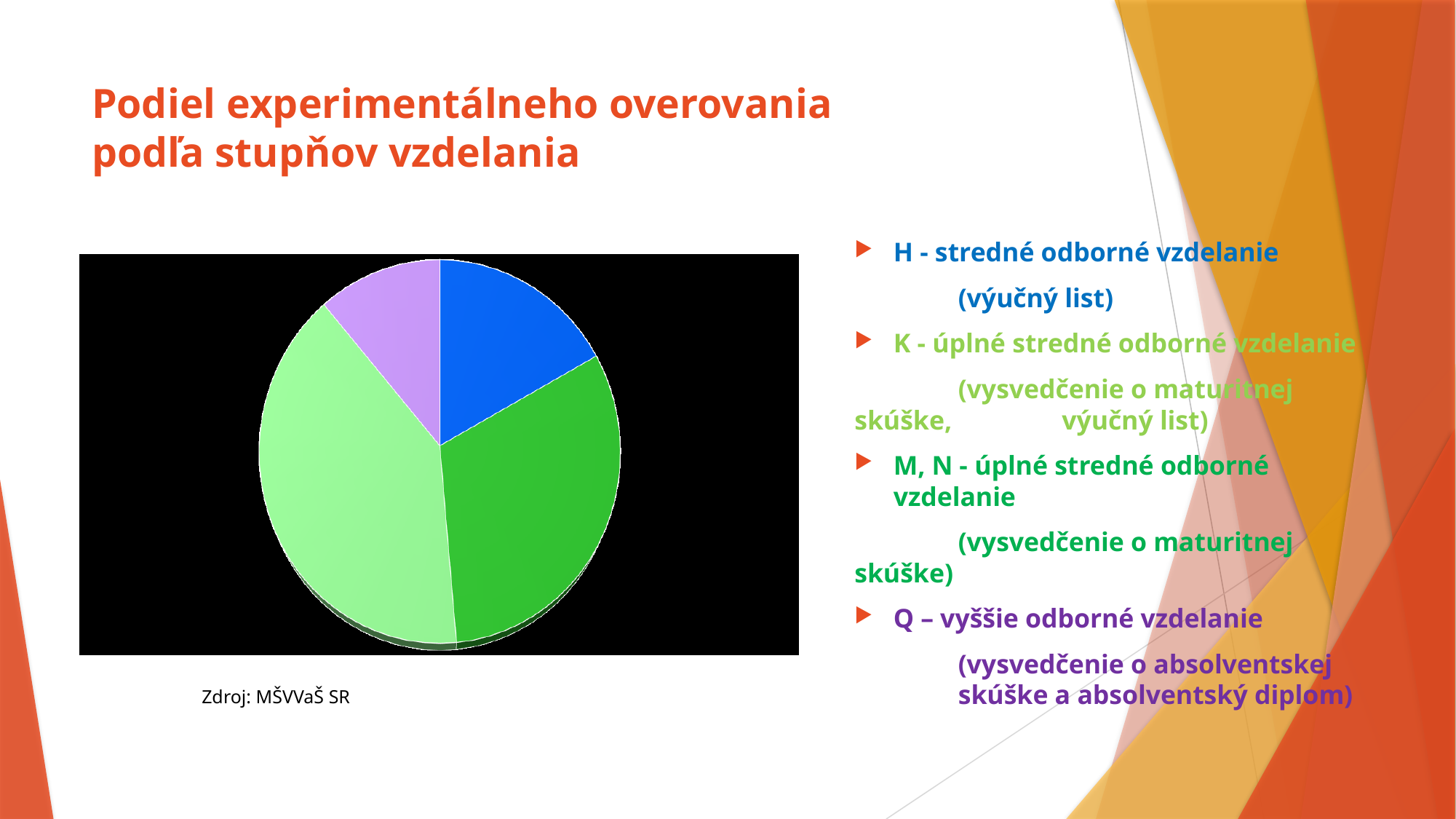
What is the title of the slide containing the pie chart? Podiel experimentálneho overovania podľa stupňov vzdelania What colour represents H - stredné odborné vzdelanie in the pie chart? Blue What kind of chart is shown on the slide? Pie chart Which slice is larger in the pie chart: the blue slice (H) or the purple slice (Q)? The blue slice (H) Which slice is larger in the pie chart: the light green slice (K) or the dark green slice (M, N)? The light green slice (K) How many slices does the pie chart have? 4 Which slice is larger in the pie chart: the dark green slice (M, N) or the blue slice (H)? The dark green slice (M, N) Which education level has the largest slice of the pie chart? K - úplné stredné odborné vzdelanie Which education level has the smallest slice of the pie chart? Q – vyššie odborné vzdelanie